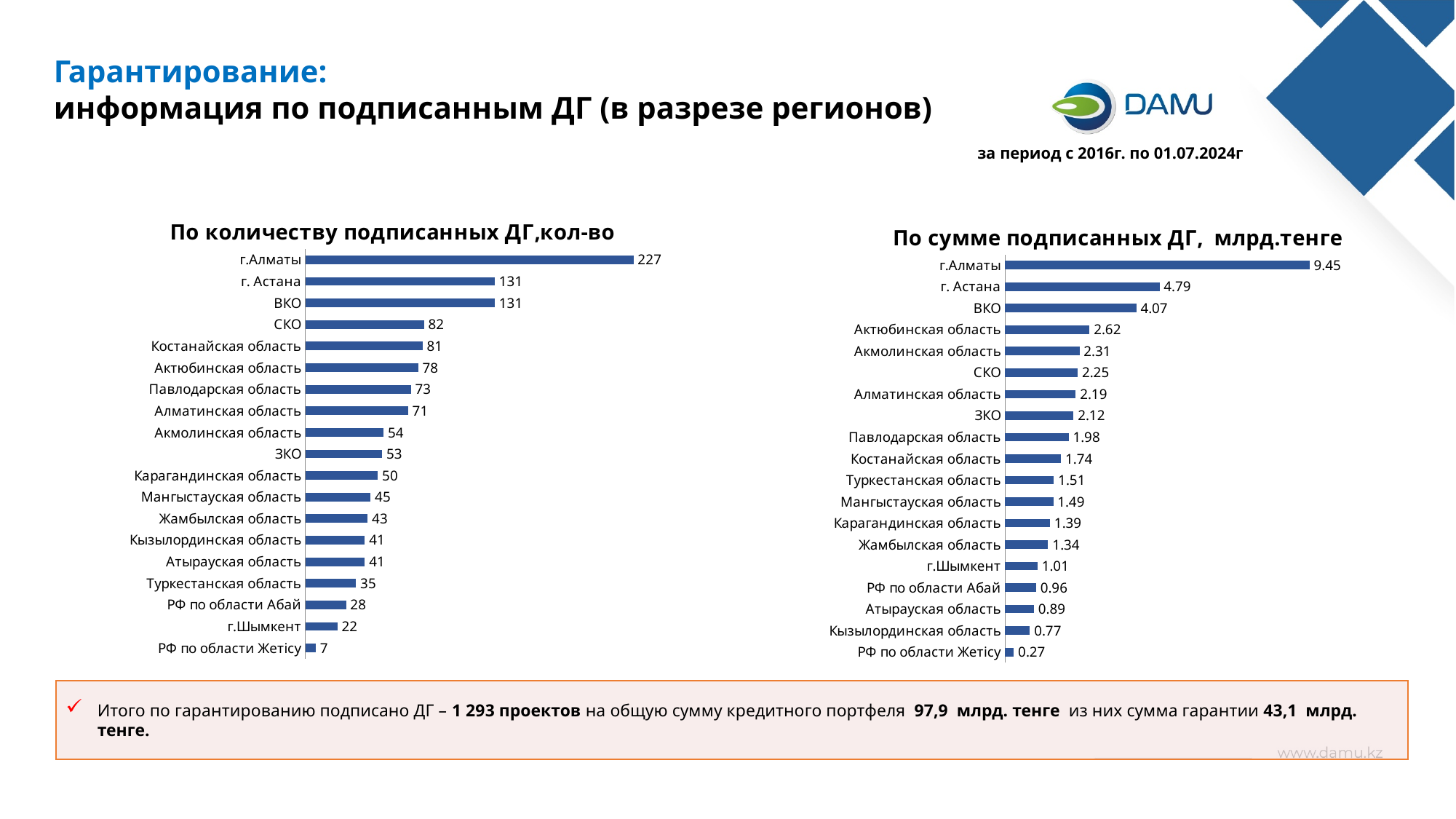
In the chart 'По количеству подписанных ДГ,кол-во', what is the difference between г.Алматы and г. Астана? 96 What period does the slide state the data covers? за период с 2016г. по 01.07.2024г In the chart 'По сумме подписанных ДГ, млрд.тенге', what is the value for г.Шымкент? 1.01 In the chart 'По количеству подписанных ДГ,кол-во', what is the value for Павлодарская область? 73 In the chart 'По сумме подписанных ДГ, млрд.тенге', which category has the highest value? г.Алматы In the chart 'По количеству подписанных ДГ,кол-во', which category has the lowest value? РФ по области Жетісу In the chart 'По количеству подписанных ДГ,кол-во', what is the value for г.Алматы? 227 In the chart 'По количеству подписанных ДГ,кол-во', how many categories are shown? 19 What type of chart is 'По сумме подписанных ДГ, млрд.тенге'? Bar chart In the chart 'По сумме подписанных ДГ, млрд.тенге', which is larger: Актюбинская область or Акмолинская область? Актюбинская область In the chart 'По сумме подписанных ДГ, млрд.тенге', what is the value for ВКО? 4.07 In the chart 'По сумме подписанных ДГ, млрд.тенге', what is the difference between г. Астана and ВКО? 0.72